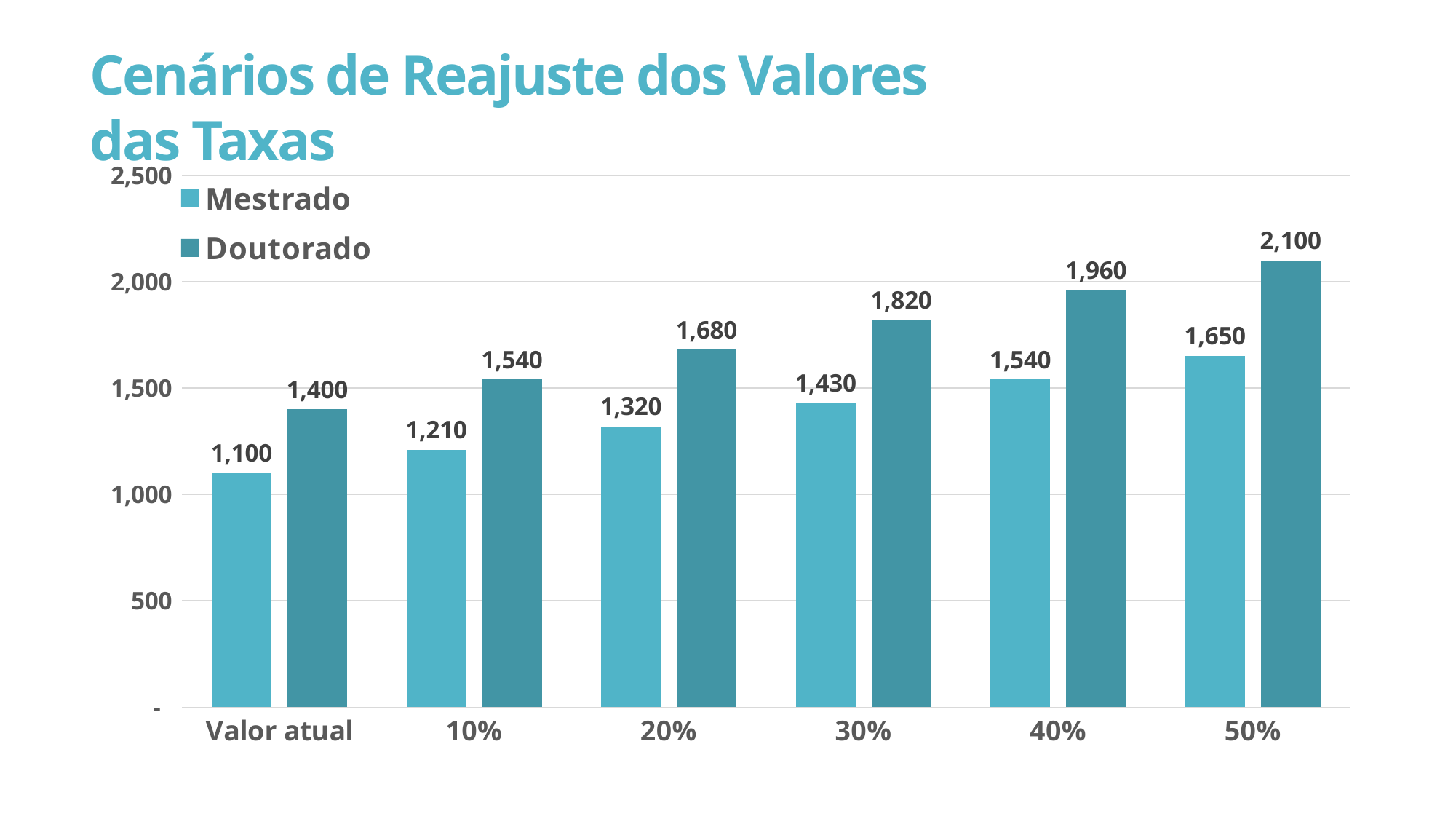
What is the Doutorado value at 30%? 1,820 Which category has the lowest Mestrado value? Valor atual What is the Mestrado value for Valor atual? 1,100 What is the Mestrado value at 40%? 1,540 How many categories are shown on the x axis? 6 What kind of chart is shown on the slide? Bar chart Which category has the highest Doutorado value? 50% What is the difference between the Doutorado and Mestrado values at 50%? 450 Do the Doutorado values rise or fall from Valor atual to 50%? Rise Which is larger: the Mestrado value at 50% or the Doutorado value at 10%? Mestrado at 50% What is the difference between the Doutorado value at 20% and the Doutorado value for Valor atual? 280 How many series does the legend list? 2